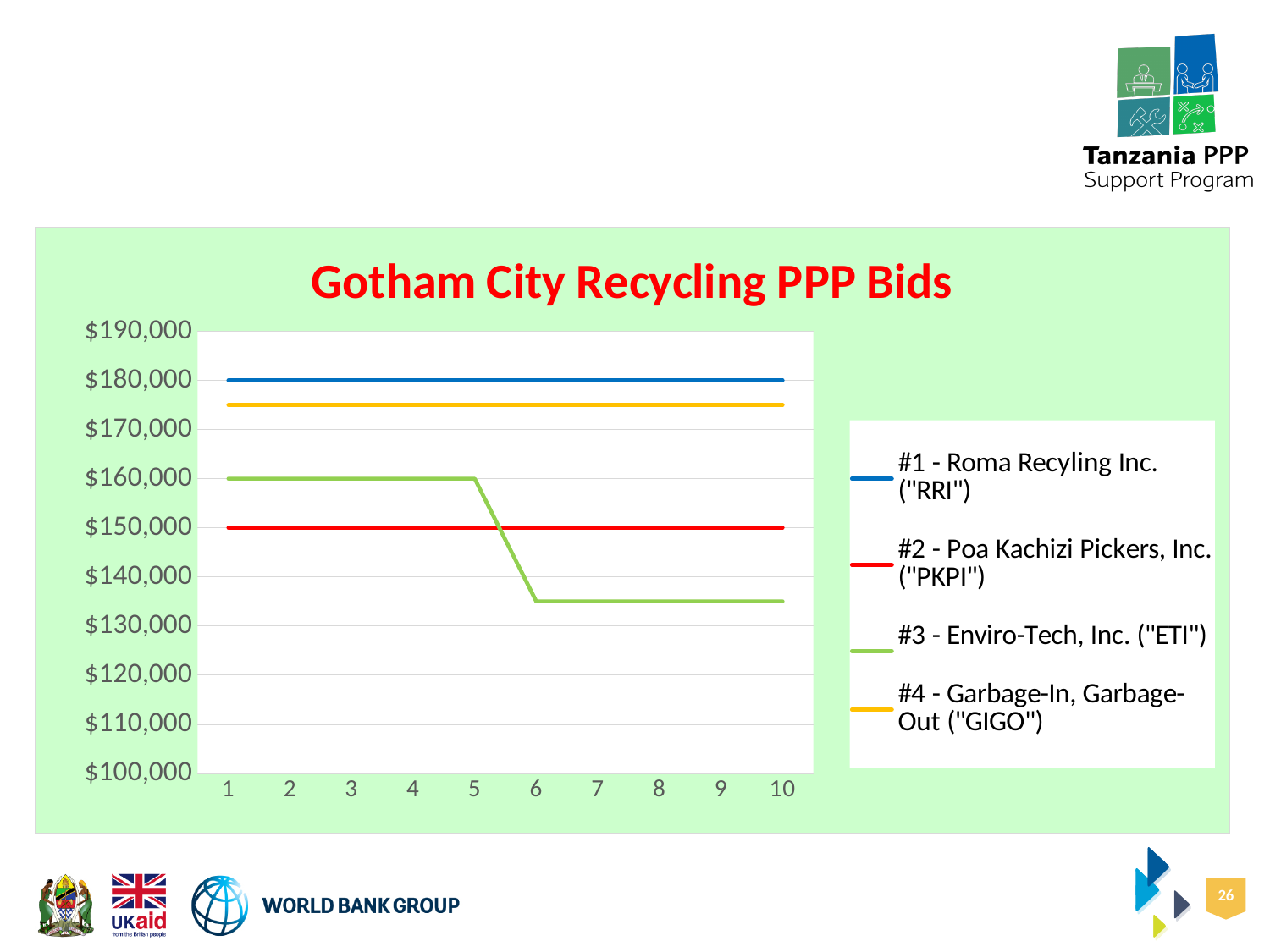
Is the value for #4 - Garbage-In, Garbage-Out ("GIGO") greater or less than $170,000? greater What is the value for #3 - Enviro-Tech, Inc. ("ETI") at point 1? $160,000 How many series does the legend list? 4 Which bidder has the highest bid value? #1 - Roma Recyling Inc. ("RRI") What is the bid value for #1 - Roma Recyling Inc. ("RRI")? $180,000 Does the line for #3 - Enviro-Tech, Inc. ("ETI") rise or fall from point 5 to point 6? fall What is the bid value for #2 - Poa Kachizi Pickers, Inc. ("PKPI")? $150,000 What is the title of the chart? Gotham City Recycling PPP Bids How many points are shown along the x axis? 10 Which bidder has the lowest value at point 10? #3 - Enviro-Tech, Inc. ("ETI") What is the difference between the RRI bid and the PKPI bid? $30,000 What type of chart is shown on the slide? line chart